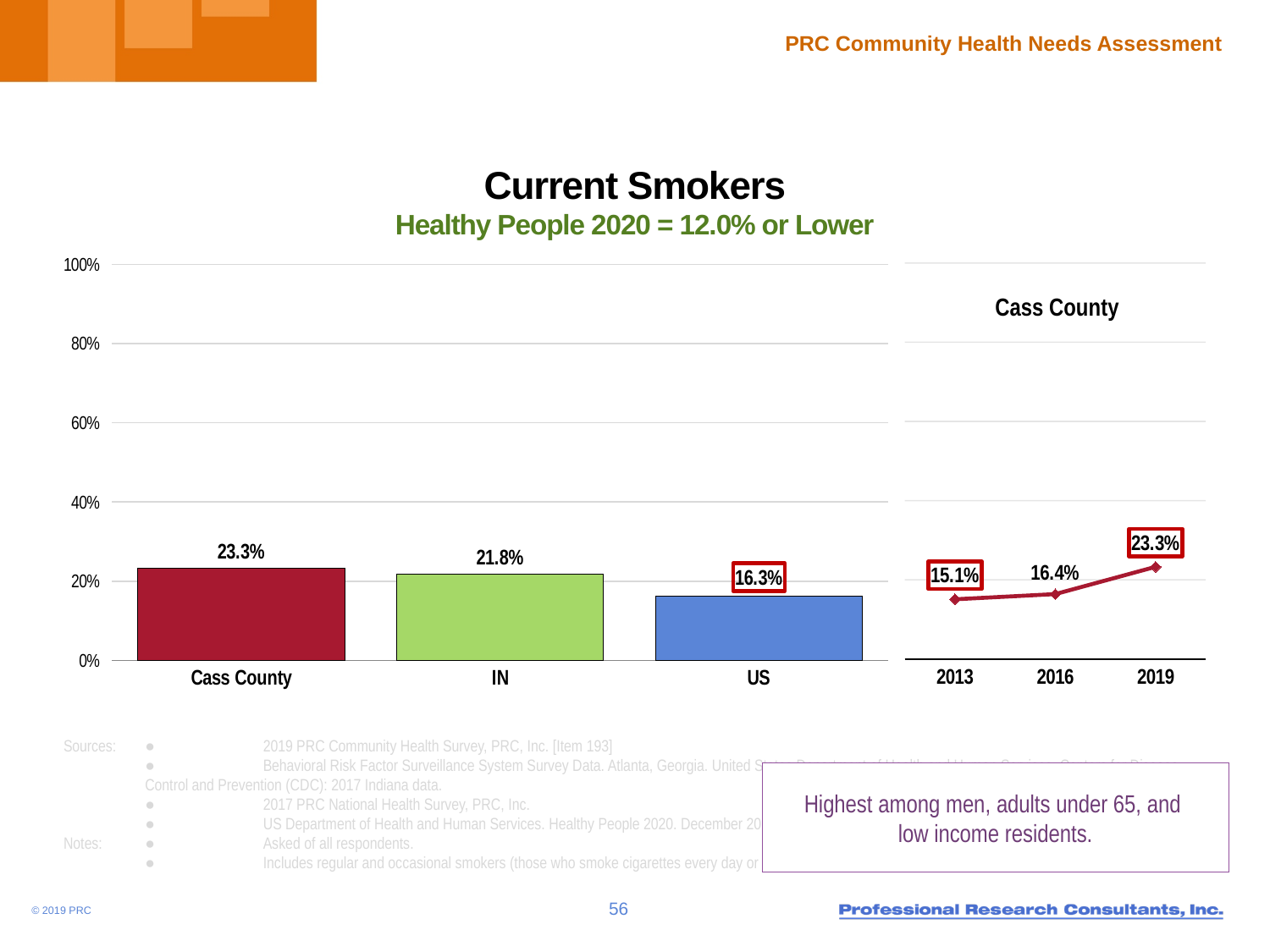
In the bar chart on the left, what is the difference between the Cass County and US values? 7.0% In the Cass County trend chart on the right, what is the value for 2013? 15.1% In the bar chart on the left, what is the value for IN? 21.8% In the Cass County trend chart on the right, what is the value for 2016? 16.4% What is the title of the chart on the slide? Current Smokers In the Cass County trend chart on the right, what is the difference between the 2019 and 2013 values? 8.2% In the Cass County trend chart on the right, do the values rise or fall from 2013 to 2019? rise In the bar chart on the left, which category has the lowest value? US In the bar chart on the left, which category has the highest value? Cass County In the bar chart on the left, what is the value for Cass County? 23.3% In the bar chart on the left, what is the value for US? 16.3% In the bar chart on the left, how many categories are shown? 3